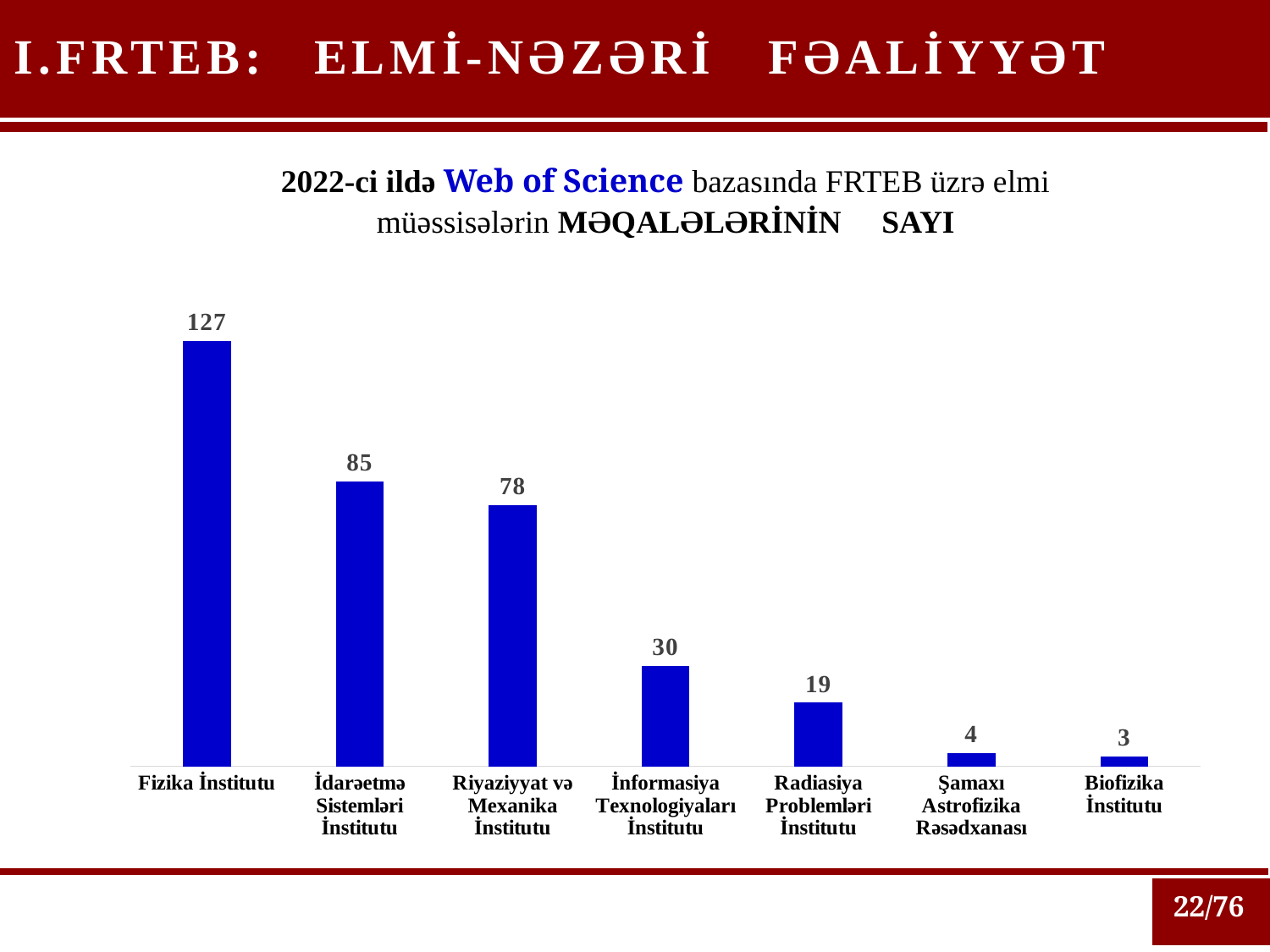
How many institutions are shown in the chart? 7 What kind of chart is shown on the slide? bar chart What is the value for Radiasiya Problemləri İnstitutu? 19 What is the difference between the values for Fizika İnstitutu and İdarəetmə Sistemləri İnstitutu? 42 Which institution has the lowest number of articles? Biofizika İnstitutu What is the value for Fizika İnstitutu? 127 What is the value for Riyaziyyat və Mexanika İnstitutu? 78 Which is larger, the value for Şamaxı Astrofizika Rəsədxanası or the value for Biofizika İnstitutu? Şamaxı Astrofizika Rəsədxanası What is the value for İdarəetmə Sistemləri İnstitutu? 85 What is the difference between the values for İnformasiya Texnologiyaları İnstitutu and Radiasiya Problemləri İnstitutu? 11 Do the values rise or fall from left to right across the chart? fall Which institution has the highest number of articles? Fizika İnstitutu